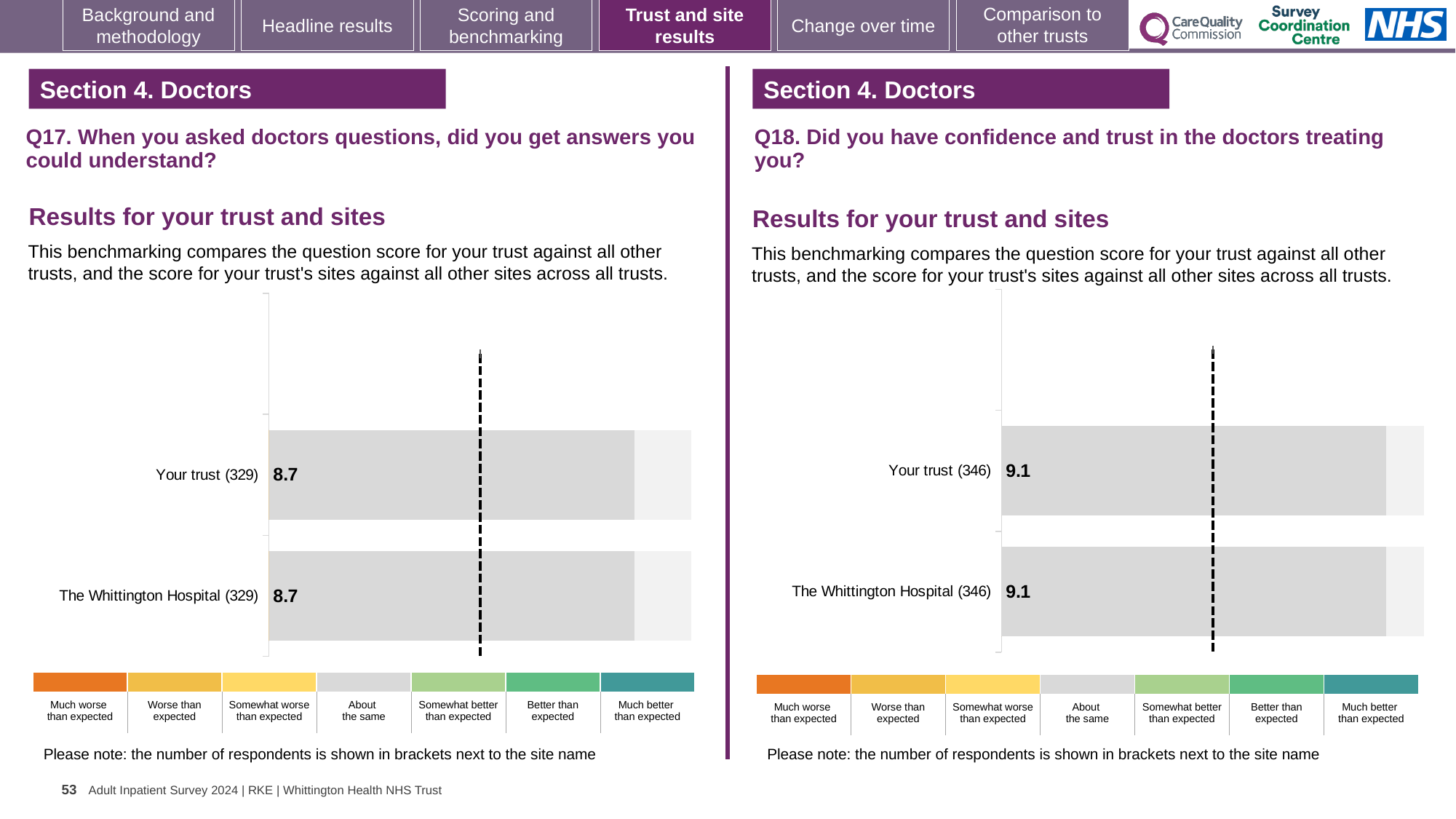
Is the score for Your trust on the Q18 chart (right) larger than the score for Your trust on the Q17 chart (left)? Yes On the Q18 chart (right), what is the score for The Whittington Hospital? 9.1 On the Q17 chart (left), what is the score for The Whittington Hospital? 8.7 On the Q18 chart (right), how many respondents are shown in brackets next to The Whittington Hospital? 346 On the Q18 chart (right), what is the score for Your trust? 9.1 How many bars are plotted on the Q17 chart (left)? 2 On the Q17 chart (left), what is the difference between the score for Your trust and the score for The Whittington Hospital? 0 What kind of chart is used on the Q18 chart (right)? Bar chart On the Q17 chart (left), how many respondents are shown in brackets next to Your trust? 329 How many bars are plotted on the Q18 chart (right)? 2 On the Q17 chart (left), what is the score for Your trust? 8.7 On the Q18 chart (right), what is the difference between the score for Your trust and the score for The Whittington Hospital? 0